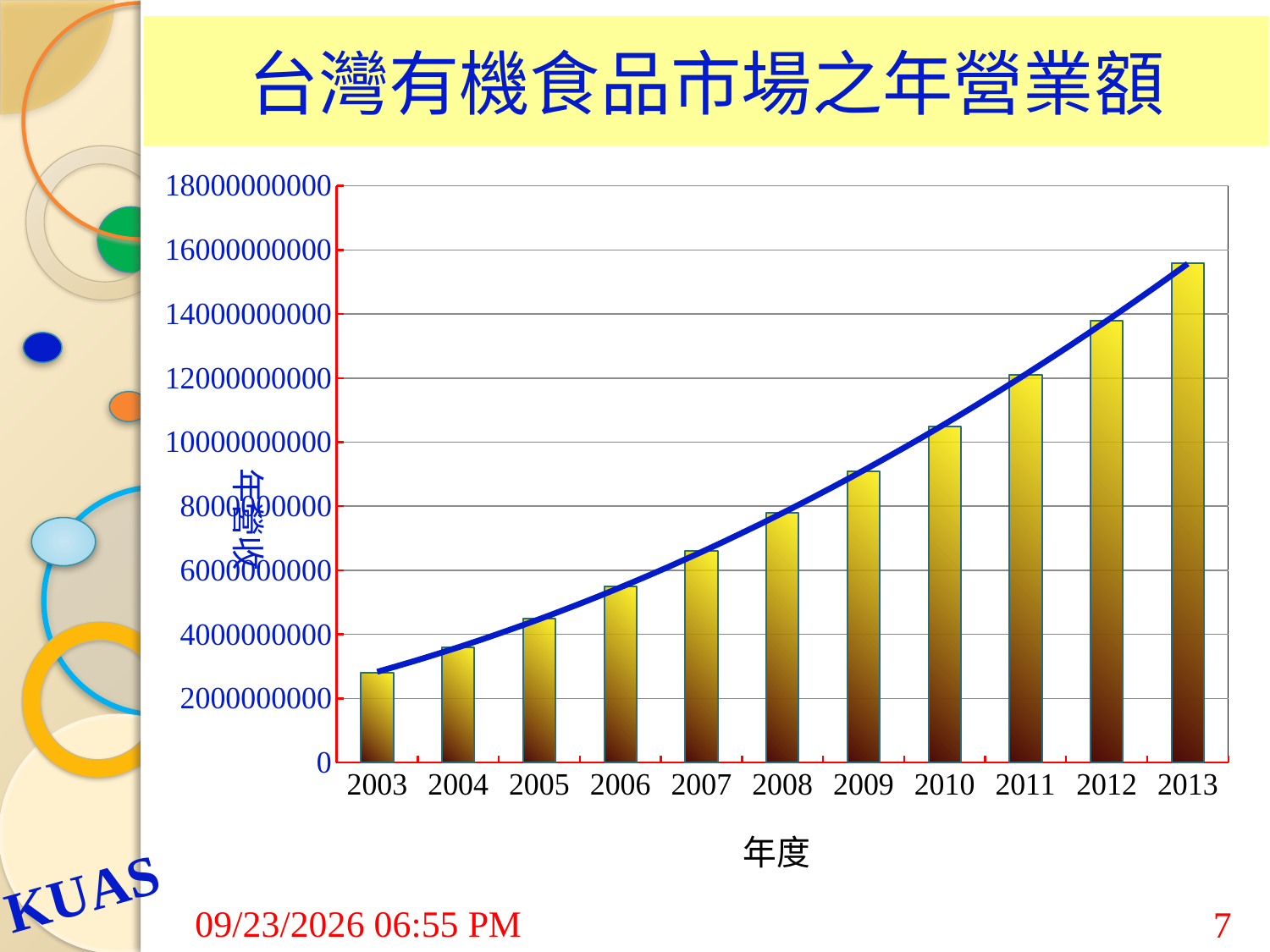
Is the value for 2006 greater or less than 6000000000? less What is the label of the x axis? 年度 Is the value for 2009 greater or less than 8000000000? greater Is the value for 2013 greater or less than 14000000000? greater What is the title of the chart? 台灣有機食品市場之年營業額 Which year has the larger value, 2008 or 2011? 2011 What kind of chart is shown on the slide? bar chart Which year has the highest value? 2013 How many years are shown on the x axis? 11 Which year has the lowest value? 2003 Do the values rise or fall from 2003 to 2013? rise